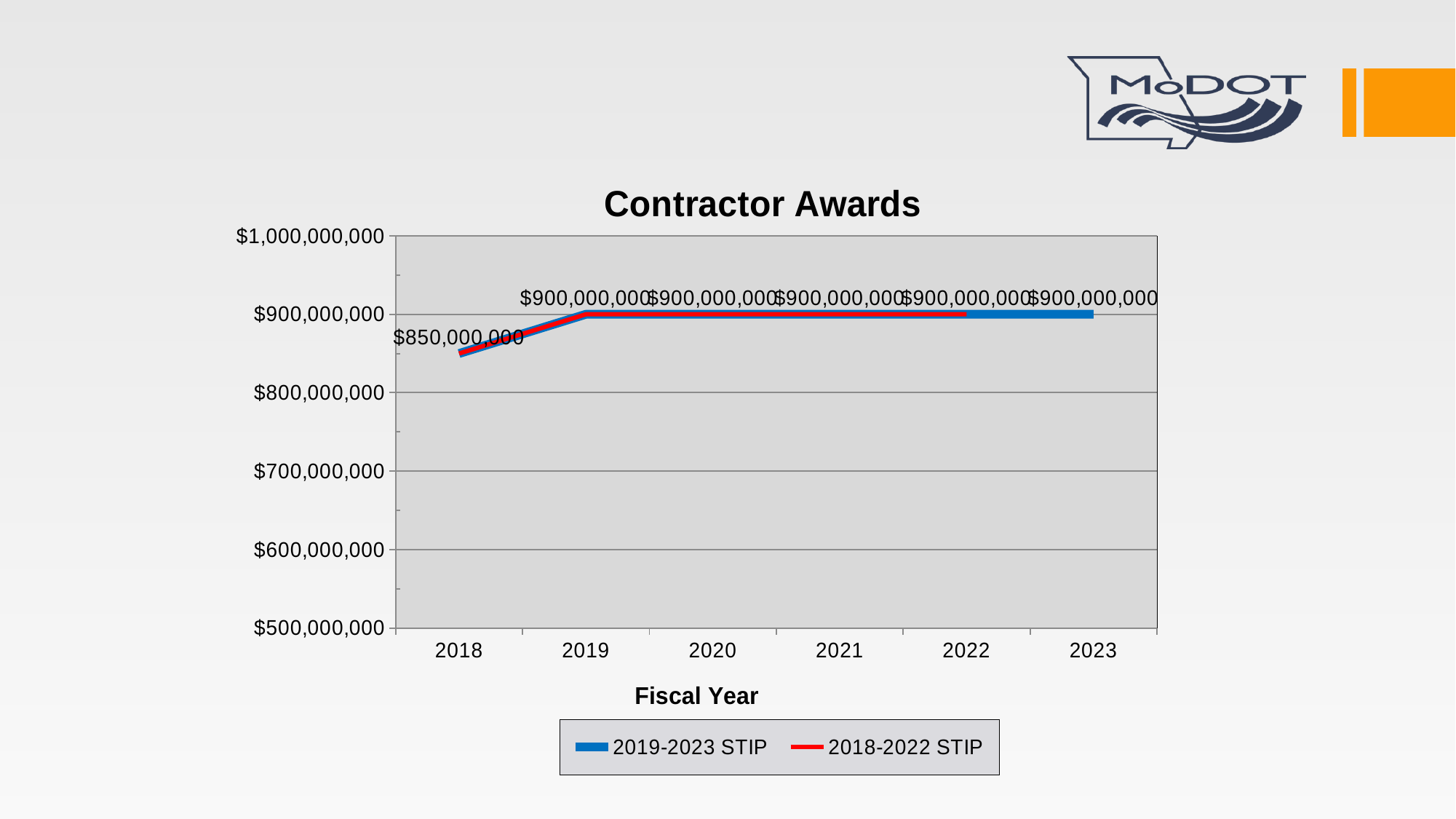
How many series does the legend list? 2 What is the difference between the contractor awards value for 2019 and for 2018? $50,000,000 What is the title of the chart? Contractor Awards What kind of chart is shown on the slide? Line chart How many fiscal years are shown on the x axis? 6 Is the contractor awards value for 2018 greater or less than $900,000,000? less Which fiscal year has the lowest contractor awards value? 2018 What is the contractor awards value for fiscal year 2023? $900,000,000 What is the contractor awards value for fiscal year 2020? $900,000,000 What is the contractor awards value for fiscal year 2018? $850,000,000 Which is larger, the contractor awards value for 2018 or for 2019? 2019 What is the label of the x axis? Fiscal Year